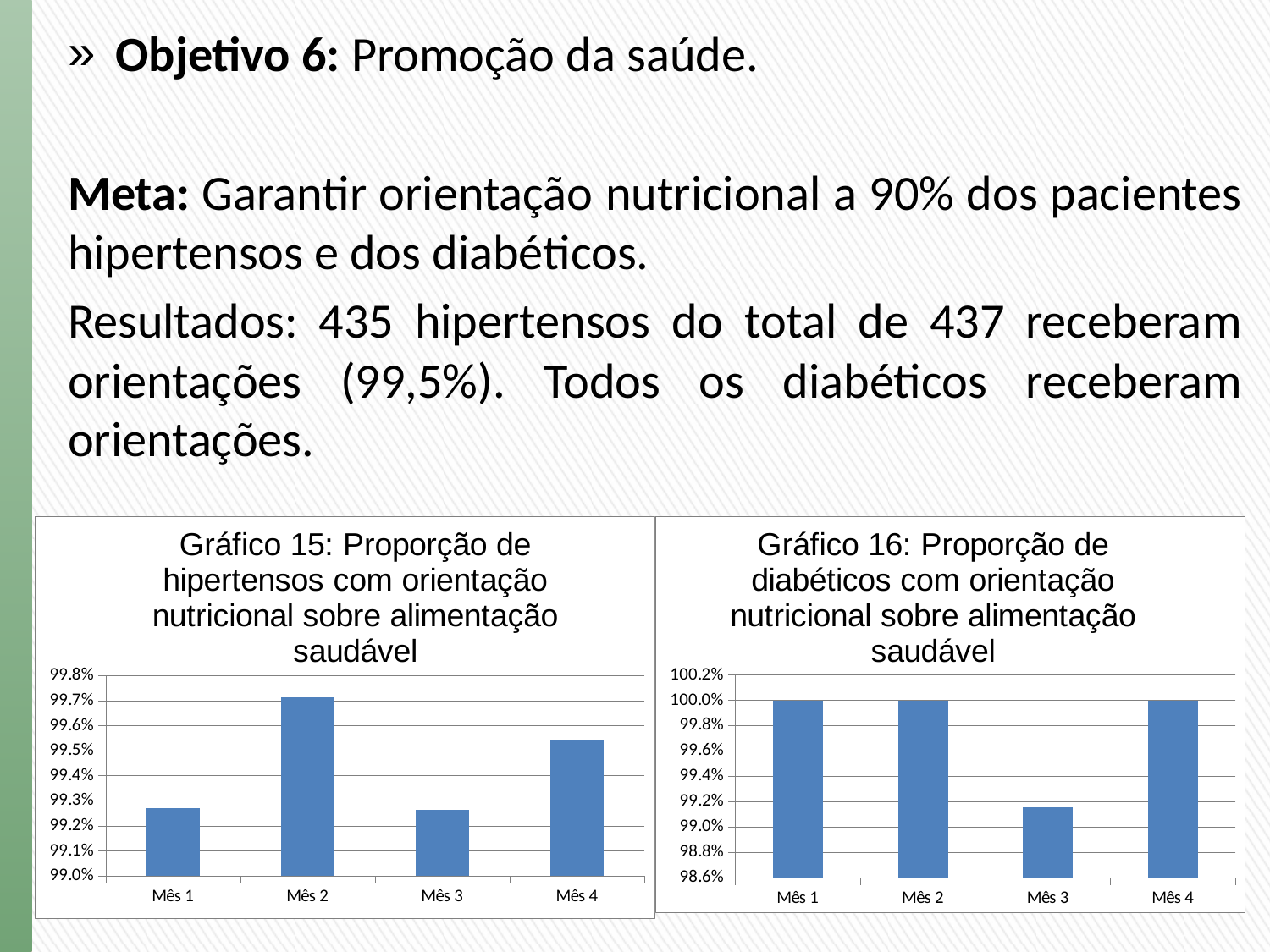
What is the title of the chart on the right of the slide? Gráfico 16: Proporção de diabéticos com orientação nutricional sobre alimentação saudável How many months are shown on the x axis of Gráfico 15? 4 What kind of chart is Gráfico 15? bar chart In Gráfico 16, is the value for Mês 3 greater or less than 99.4%? less In Gráfico 15, is the value for Mês 1 greater or less than 99.4%? less In Gráfico 16, what is the proportion of diabetic patients with nutritional guidance in Mês 1? 100.0% In Gráfico 16, which month has the lowest proportion? Mês 3 In Gráfico 16, which is larger, the value for Mês 2 or the value for Mês 3? Mês 2 In Gráfico 15, is the value for Mês 2 greater or less than 99.6%? greater In Gráfico 15, which month has the highest proportion of hypertensive patients with nutritional guidance? Mês 2 In Gráfico 16, what is the value for Mês 4? 100.0% In Gráfico 15, which is larger, the value for Mês 4 or the value for Mês 3? Mês 4